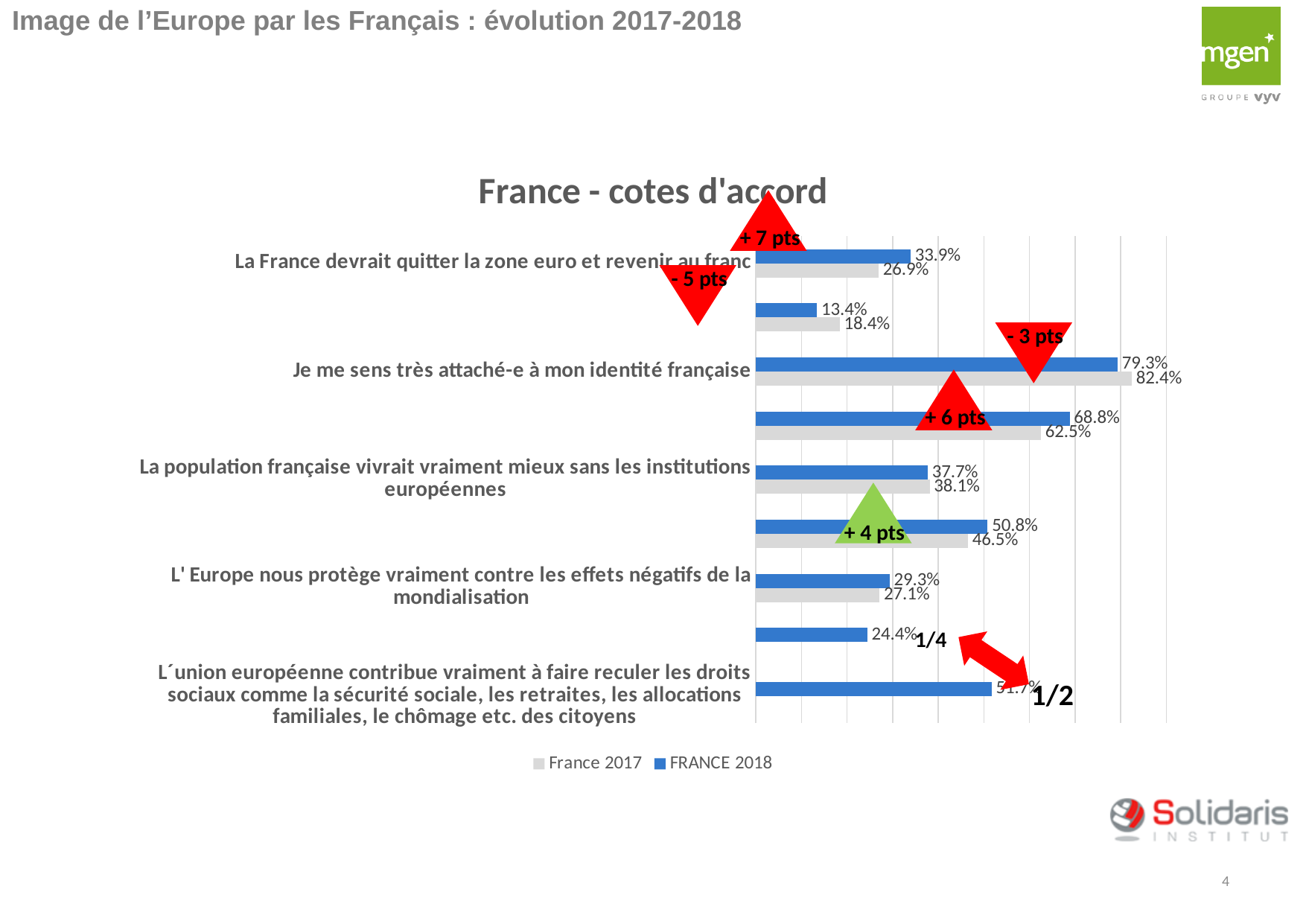
What is the FRANCE 2018 value for "Je me sens très attaché-e à mon identité française"? 79.3% By how many percentage points does the FRANCE 2018 value exceed the France 2017 value for "La France devrait quitter la zone euro et revenir au franc"? 7 percentage points Which category has the highest FRANCE 2018 value? Je me sens très attaché-e à mon identité française How many series does the legend list? 2 What is the FRANCE 2018 value for "La France devrait quitter la zone euro et revenir au franc"? 33.9% What is the France 2017 value for "La France devrait quitter la zone euro et revenir au franc"? 26.9% What is the FRANCE 2018 value for "L' Europe nous protège vraiment contre les effets négatifs de la mondialisation"? 29.3% What kind of chart is shown on the slide? Bar chart What is the title of the chart? France - cotes d'accord What is the France 2017 value for "La population française vivrait vraiment mieux sans les institutions européennes"? 38.1% What is the France 2017 value for "Je me sens très attaché-e à mon identité française"? 82.4% For "Je me sens très attaché-e à mon identité française", which series has the larger value, France 2017 or FRANCE 2018? France 2017